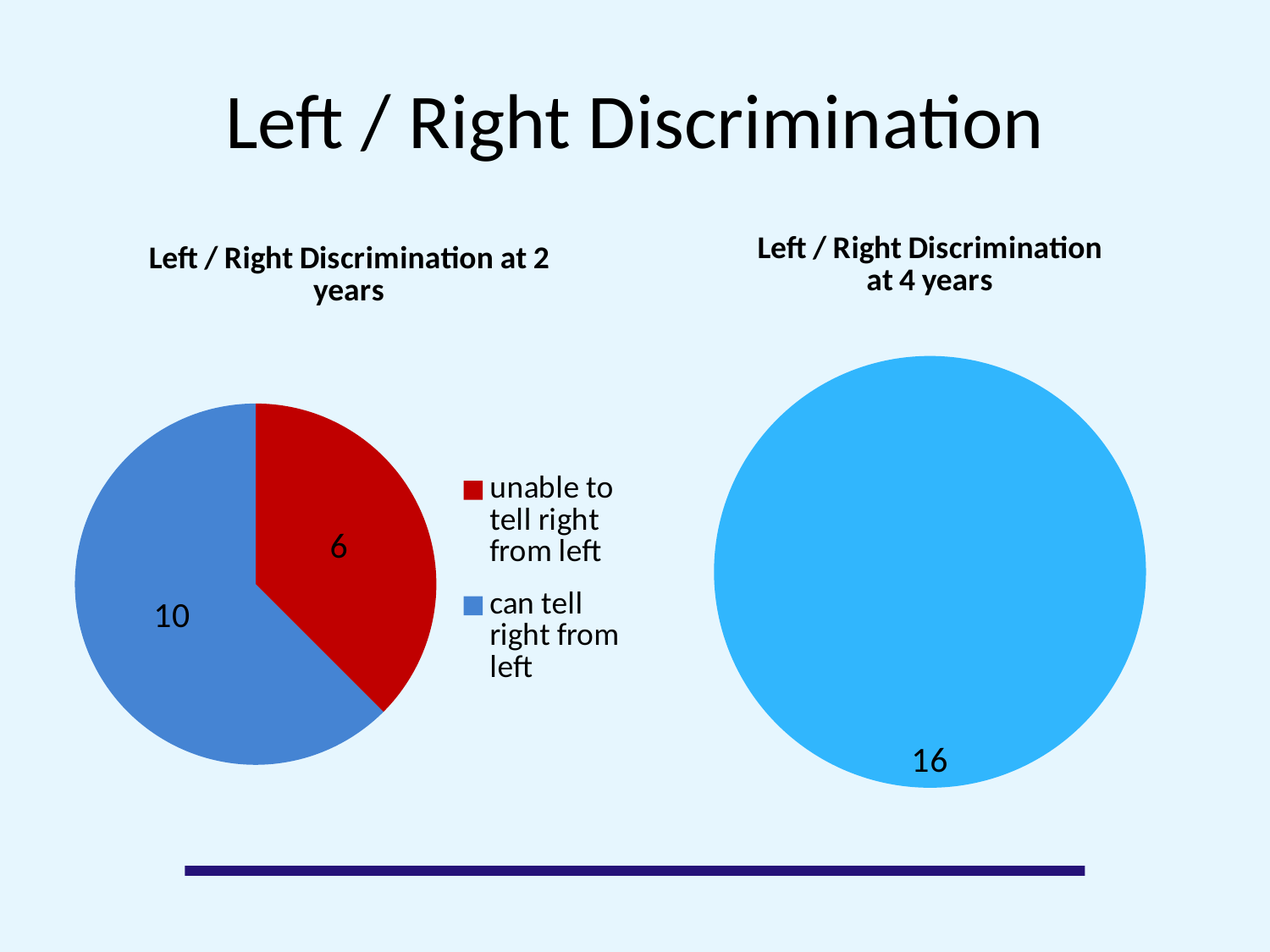
In the 'Left / Right Discrimination at 2 years' chart, what share of the pie is 'unable to tell right from left'? 37.5% In the 'Left / Right Discrimination at 2 years' chart, which category has the smallest slice? unable to tell right from left In the 'Left / Right Discrimination at 2 years' chart, what is the total of the two slices? 16 In the 'Left / Right Discrimination at 2 years' chart, which is larger: 'unable to tell right from left' or 'can tell right from left'? can tell right from left In the 'Left / Right Discrimination at 2 years' chart, which category has the largest slice? can tell right from left In the 'Left / Right Discrimination at 2 years' chart, what colour is the 'unable to tell right from left' slice? red In the 'Left / Right Discrimination at 2 years' chart, what is the value for 'can tell right from left'? 10 What kind of chart is the 'Left / Right Discrimination at 4 years' chart? pie chart In the 'Left / Right Discrimination at 4 years' chart, what value is printed on the pie? 16 In the 'Left / Right Discrimination at 2 years' chart, how many categories does the legend list? 2 In the 'Left / Right Discrimination at 2 years' chart, what is the value for 'unable to tell right from left'? 6 In the 'Left / Right Discrimination at 2 years' chart, what is the difference between 'can tell right from left' and 'unable to tell right from left'? 4